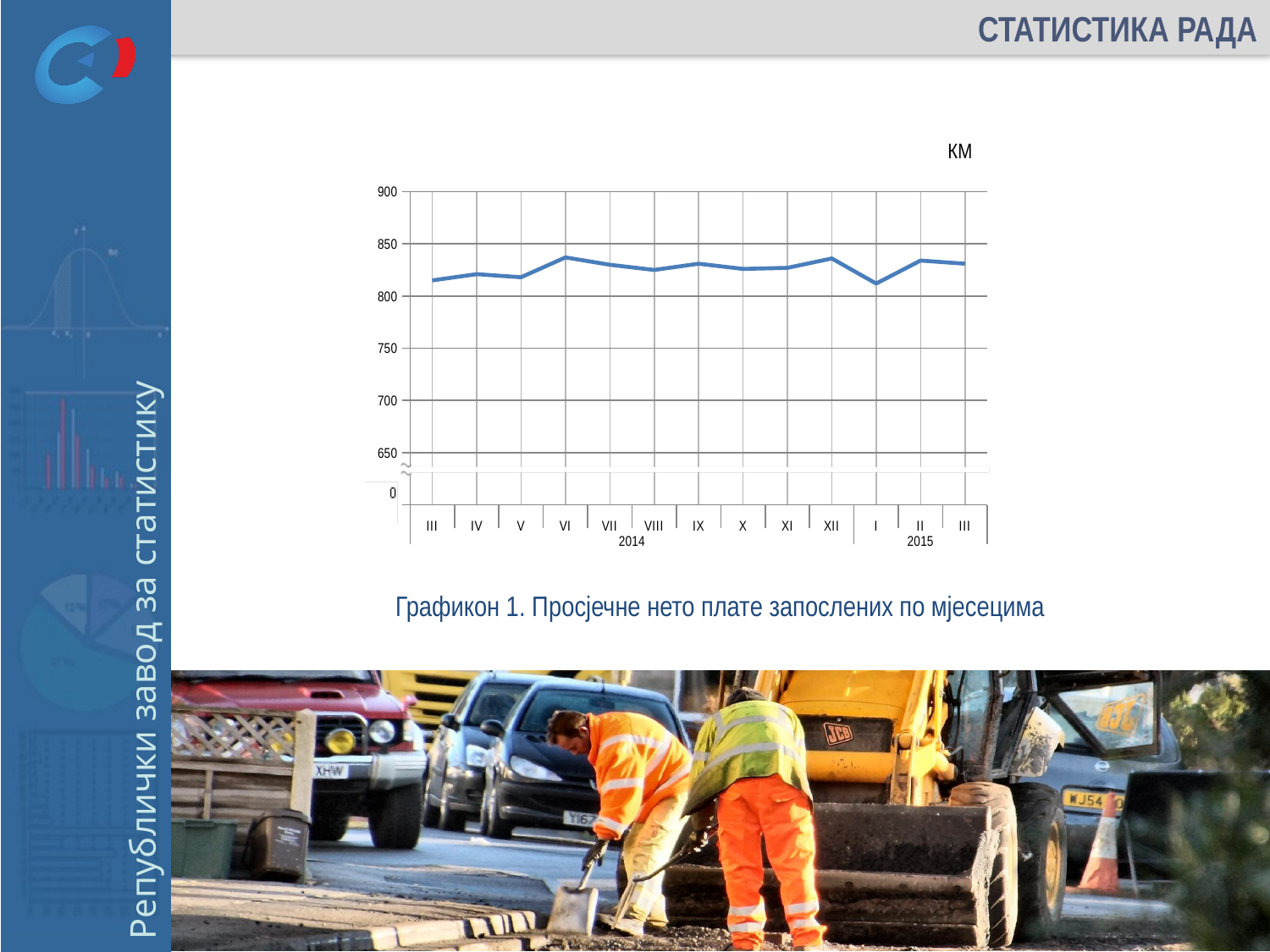
Which is larger, the value for month VI of 2014 or the value for month V of 2014? VI 2014 Is the value for month I of 2015 greater or less than 850? less How many monthly data points are plotted on the chart? 13 What unit is indicated above the chart? КМ What is the title of the chart on the slide? Графикон 1. Просјечне нето плате запослених по мјесецима What kind of chart is shown on the slide? line chart Does the line rise or fall from month III of 2014 to month VI of 2014? rise Is the value for month III of 2014 greater or less than 750? greater Is the value for month VI of 2014 greater or less than 800? greater Does the line rise or fall from month XII of 2014 to month I of 2015? fall Which is larger, the value for month I of 2015 or the value for month XII of 2014? XII 2014